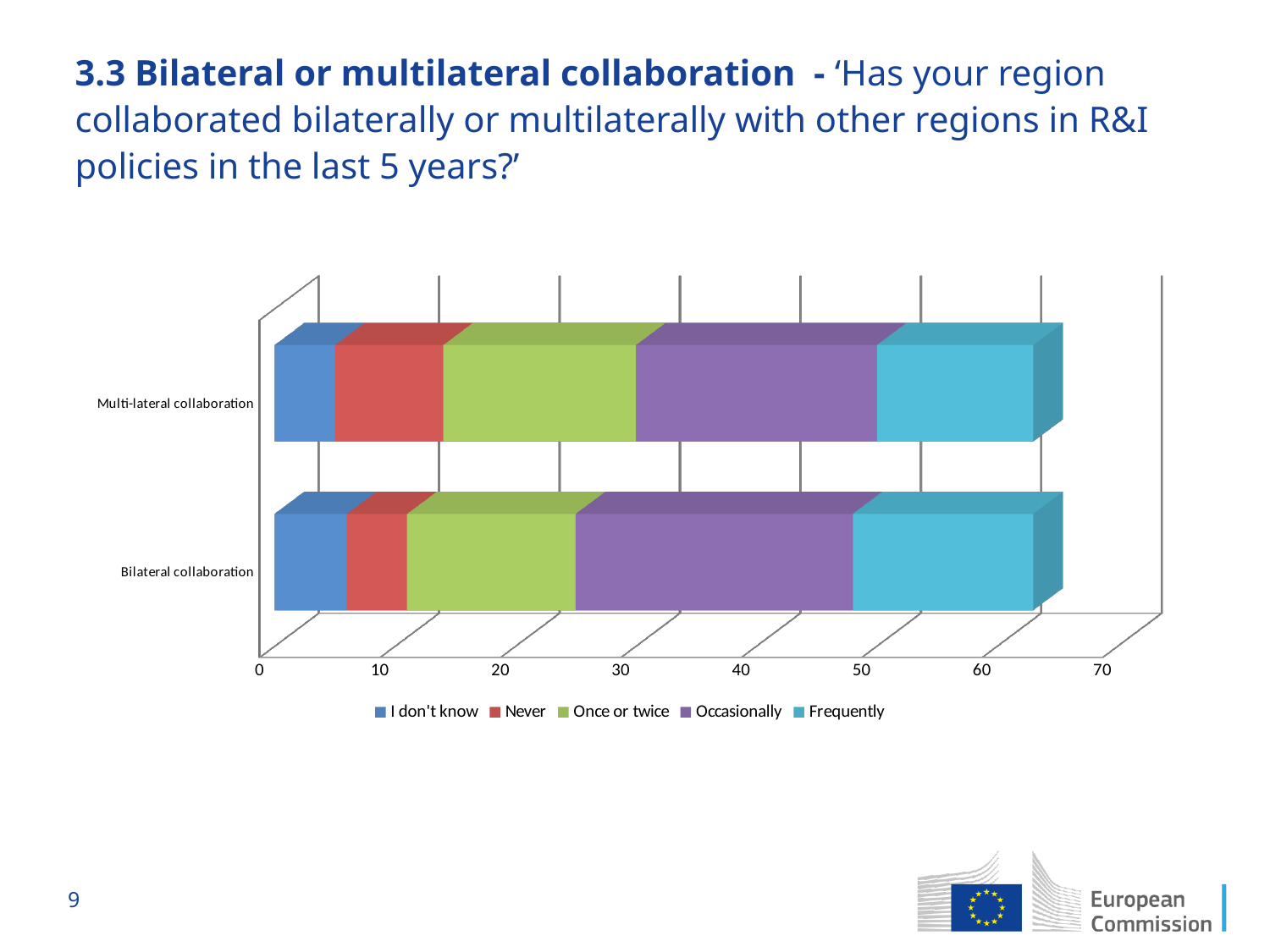
Is the 'Occasionally' segment of the Bilateral collaboration bar greater or less than 10? greater Which response makes up the largest segment of the Bilateral collaboration bar? Occasionally What kind of chart is shown on the slide? Stacked bar chart How many series does the legend list? 5 Is the total length of the Multi-lateral collaboration bar greater or less than 60? greater What colour represents the 'Frequently' series in the chart? Light blue Is the 'Never' segment larger for Multi-lateral collaboration or for Bilateral collaboration? Multi-lateral collaboration Which response makes up the largest segment of the Multi-lateral collaboration bar? Occasionally Is the total length of the Bilateral collaboration bar greater or less than 70? less Which response makes up the smallest segment of the Multi-lateral collaboration bar? I don't know How many categories (bars) does the chart show? 2 What are the series listed in the legend? I don't know, Never, Once or twice, Occasionally, Frequently